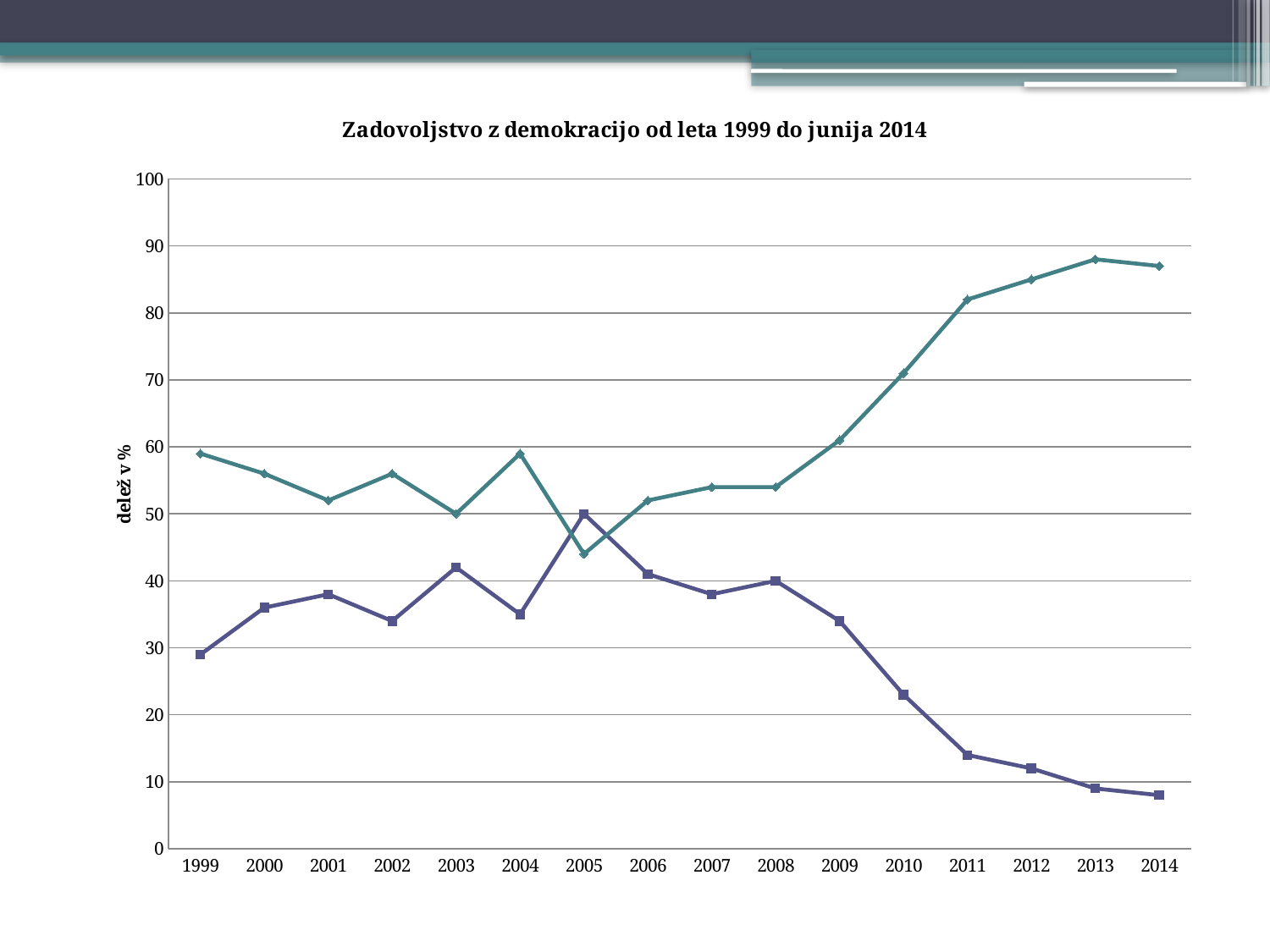
What is the value of the teal line in 2003? 50 What is the label on the vertical axis? delež v % What kind of chart is shown on the slide? line chart How many years are plotted along the x axis? 16 Does the purple line generally rise or fall from 2008 to 2014? fall In which year does the purple line reach its lowest value? 2014 In which year does the teal line reach its highest value? 2013 What is the value of the purple line in 2005? 50 Is the value of the purple line in 2014 greater or less than 10? less What is the title of the chart? Zadovoljstvo z demokracijo od leta 1999 do junija 2014 Is the value of the teal line in 2014 greater or less than 80? greater In 2005, which line has the higher value, the teal line or the purple line? the purple line